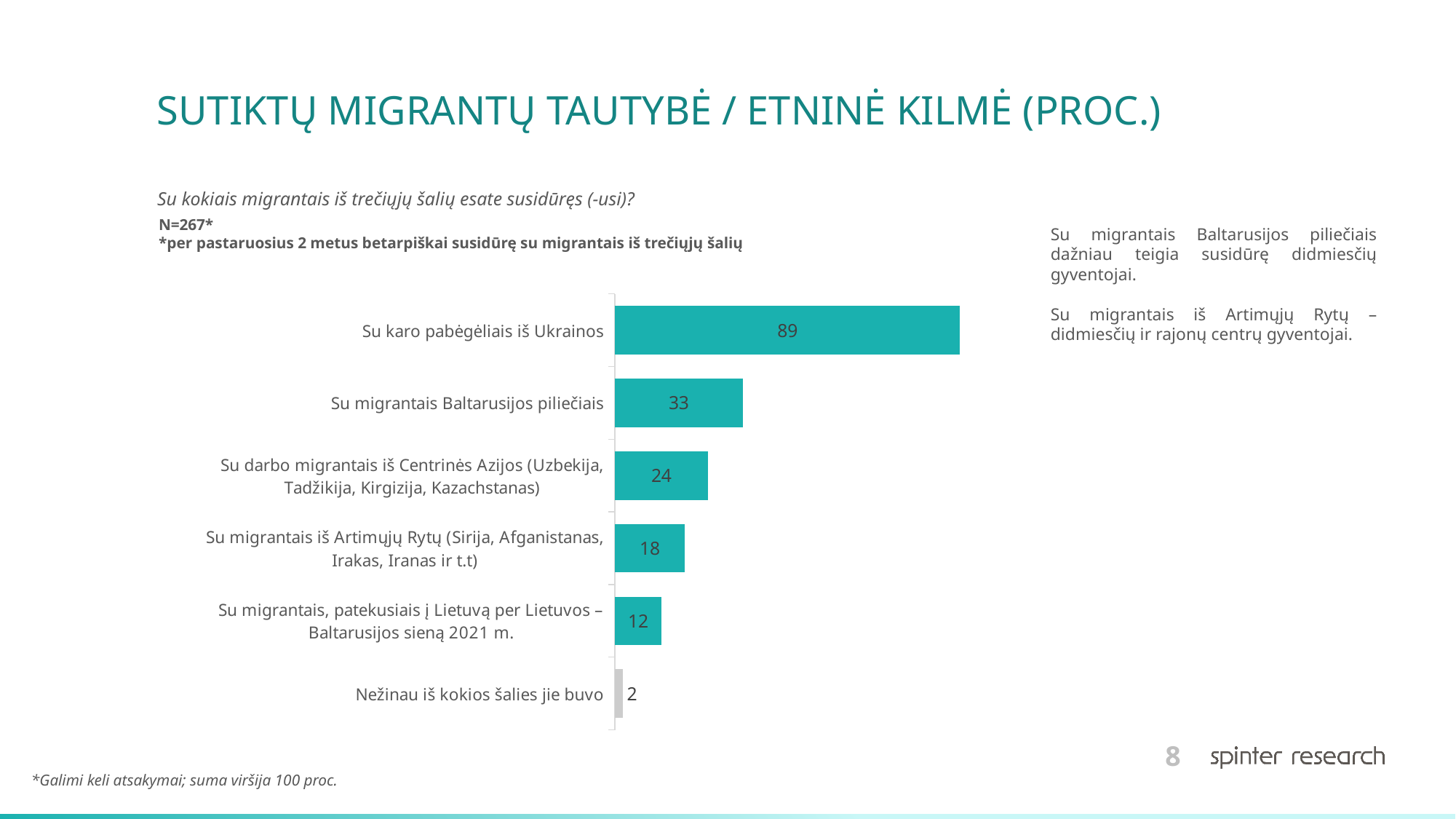
What is the value for "Su darbo migrantais iš Centrinės Azijos (Uzbekija, Tadžikija, Kirgizija, Kazachstanas)"? 24 Which category has the highest value? Su karo pabėgėliais iš Ukrainos How many categories are shown in the chart? 6 What is the difference between the values for "Su karo pabėgėliais iš Ukrainos" and "Su migrantais Baltarusijos piliečiais"? 56 What is the value for "Su karo pabėgėliais iš Ukrainos"? 89 Which is larger: the value for "Su darbo migrantais iš Centrinės Azijos" or the value for "Su migrantais iš Artimųjų Rytų"? Su darbo migrantais iš Centrinės Azijos What is the value for "Su migrantais, patekusiais į Lietuvą per Lietuvos – Baltarusijos sieną 2021 m."? 12 What is the value for "Su migrantais Baltarusijos piliečiais"? 33 Which category has the lowest value? Nežinau iš kokios šalies jie buvo What is the difference between the values for "Su migrantais iš Artimųjų Rytų (Sirija, Afganistanas, Irakas, Iranas ir t.t)" and "Nežinau iš kokios šalies jie buvo"? 16 What kind of chart is shown on the slide? Bar chart What is the sample size (N) stated above the chart? N=267*